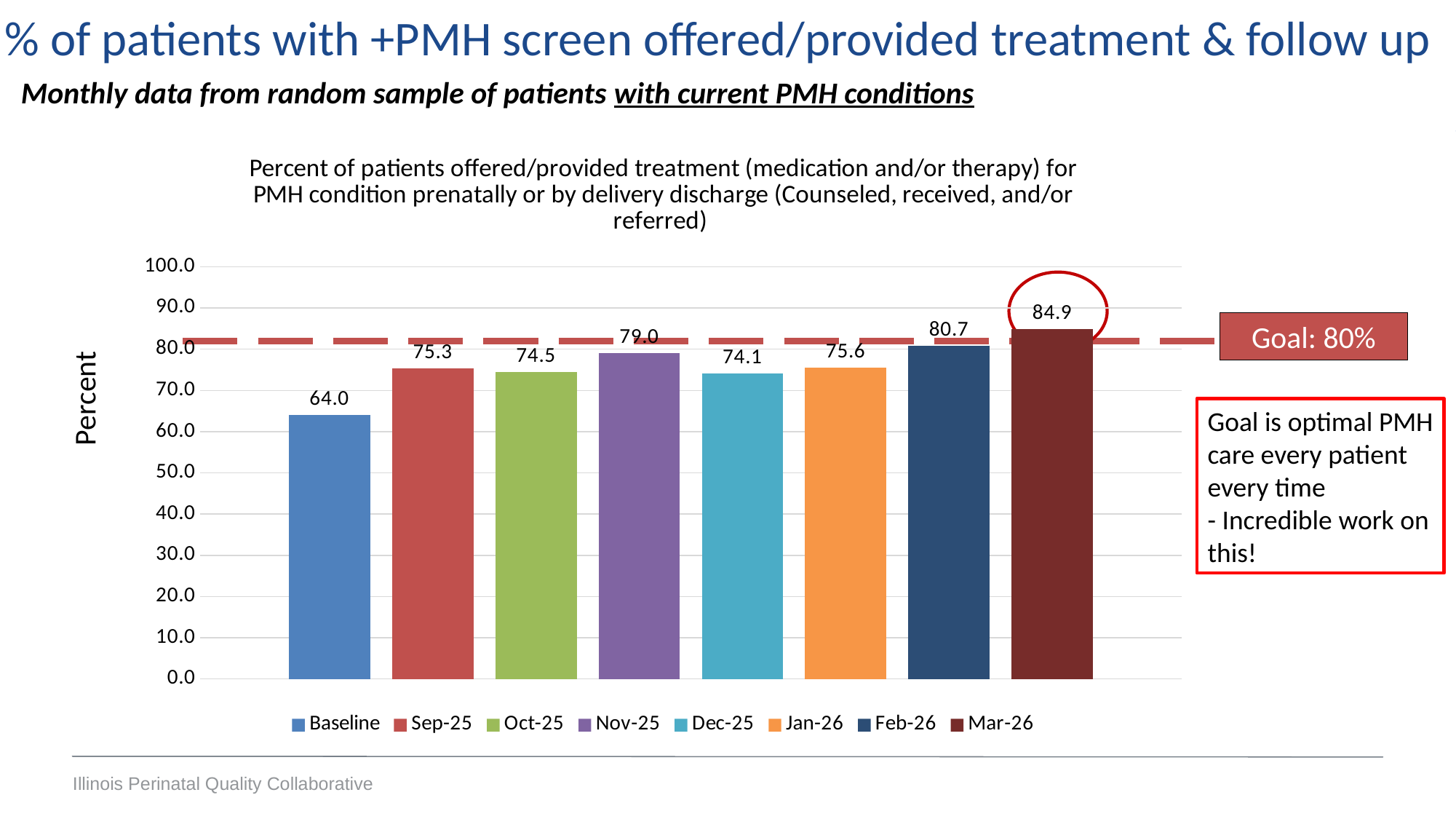
What goal value is marked by the dashed line on the chart? 80% What is the value for Mar-26? 84.9 Which category has the highest value? Mar-26 How many entries does the legend list? 8 What is the value for Baseline? 64.0 What is the value for Nov-25? 79.0 What is the difference between the Mar-26 value and the Baseline value? 20.9 Is the value for Dec-25 greater or less than 80.0? less What kind of chart is shown on the slide? bar chart Which is larger, the value for Feb-26 or the value for Jan-26? Feb-26 How many bars are plotted in the chart? 8 Which category has the lowest value? Baseline